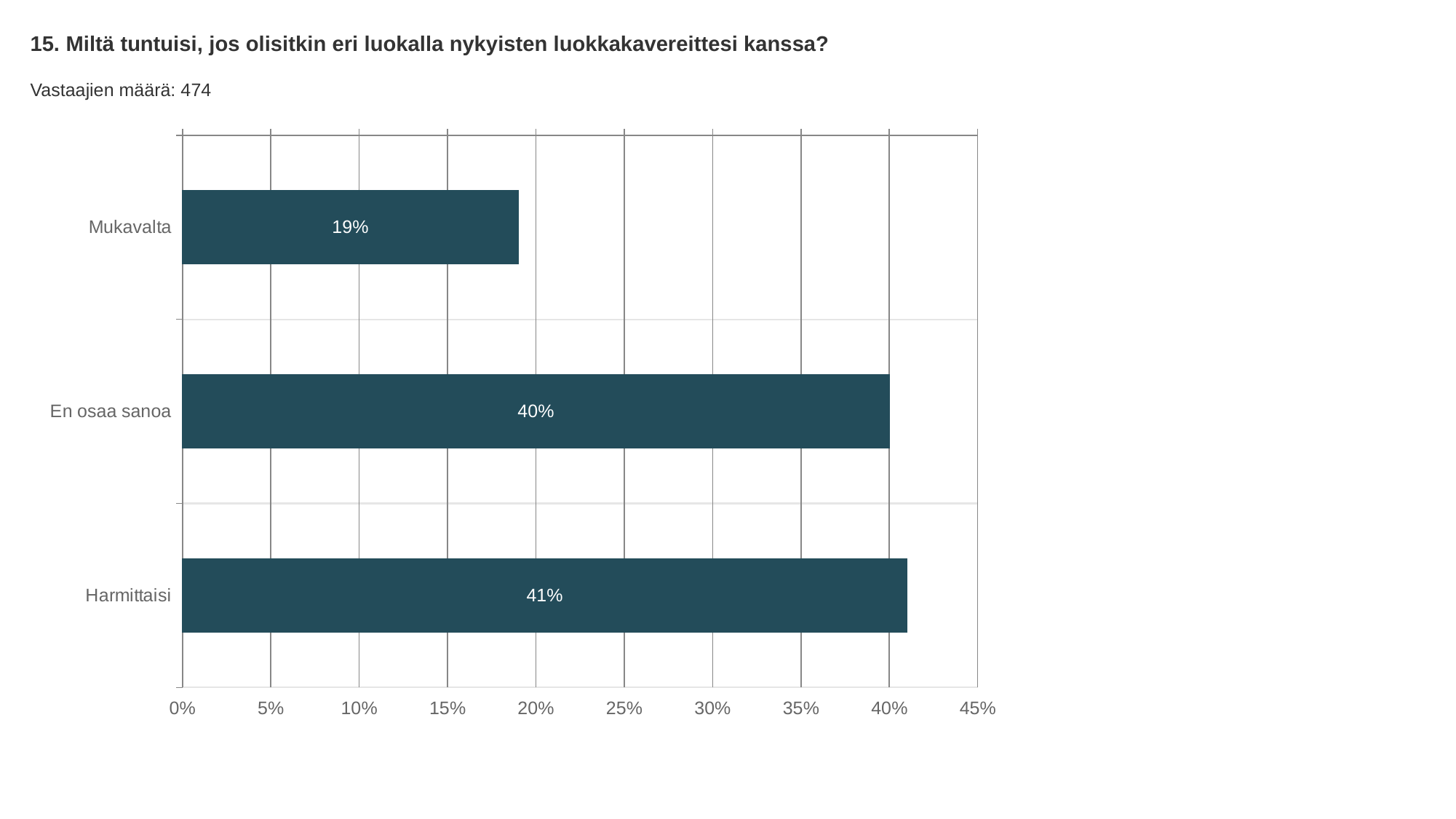
What is the value for Harmittaisi? 41% Which is larger, the value for En osaa sanoa or the value for Mukavalta? En osaa sanoa How many respondents (Vastaajien määrä) are reported on the slide? 474 What is the value for Mukavalta? 19% Is the value for Harmittaisi greater or less than 35%? greater How many categories are shown in the chart? 3 What is the difference between the values for Harmittaisi and Mukavalta? 22% What is the value for En osaa sanoa? 40% What is the difference between the values for En osaa sanoa and Mukavalta? 21% Which category has the lowest value? Mukavalta What kind of chart is shown on the slide? bar chart Is the value for Mukavalta greater or less than 20%? less